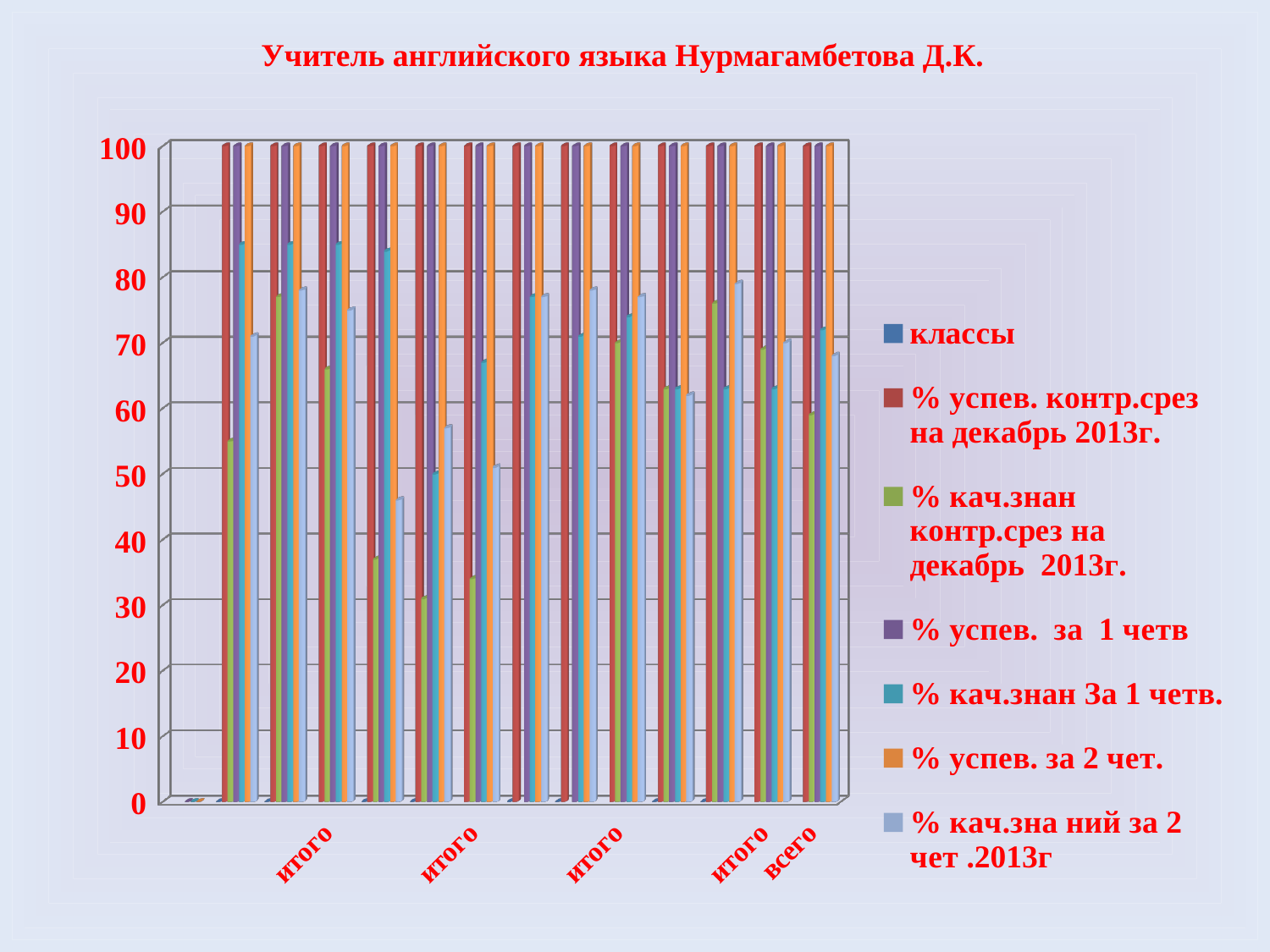
Is the value of "% кач.знан За 1 четв." for "всего" greater or less than 80? less Is the value of "% кач.зна ний за 2 чет .2013г" for "всего" greater or less than 80? less Is the value of "% успев. за 1 четв" for "всего" greater or less than 90? greater What kind of chart is shown on the slide? bar chart What is the title of the slide above the chart? Учитель английского языка Нурмагамбетова Д.К. Which series is listed first in the legend? классы How many series does the legend list? 7 For the category "всего", which is larger: "% кач.знан За 1 четв." or "% кач.знан контр.срез на декабрь 2013г."? % кач.знан За 1 четв. What is the highest value shown on the vertical axis? 100 What is the value of "% успев. за 2 чет." for the category "всего"? 100 What is the value of "% успев. контр.срез на декабрь 2013г." for the category "всего"? 100